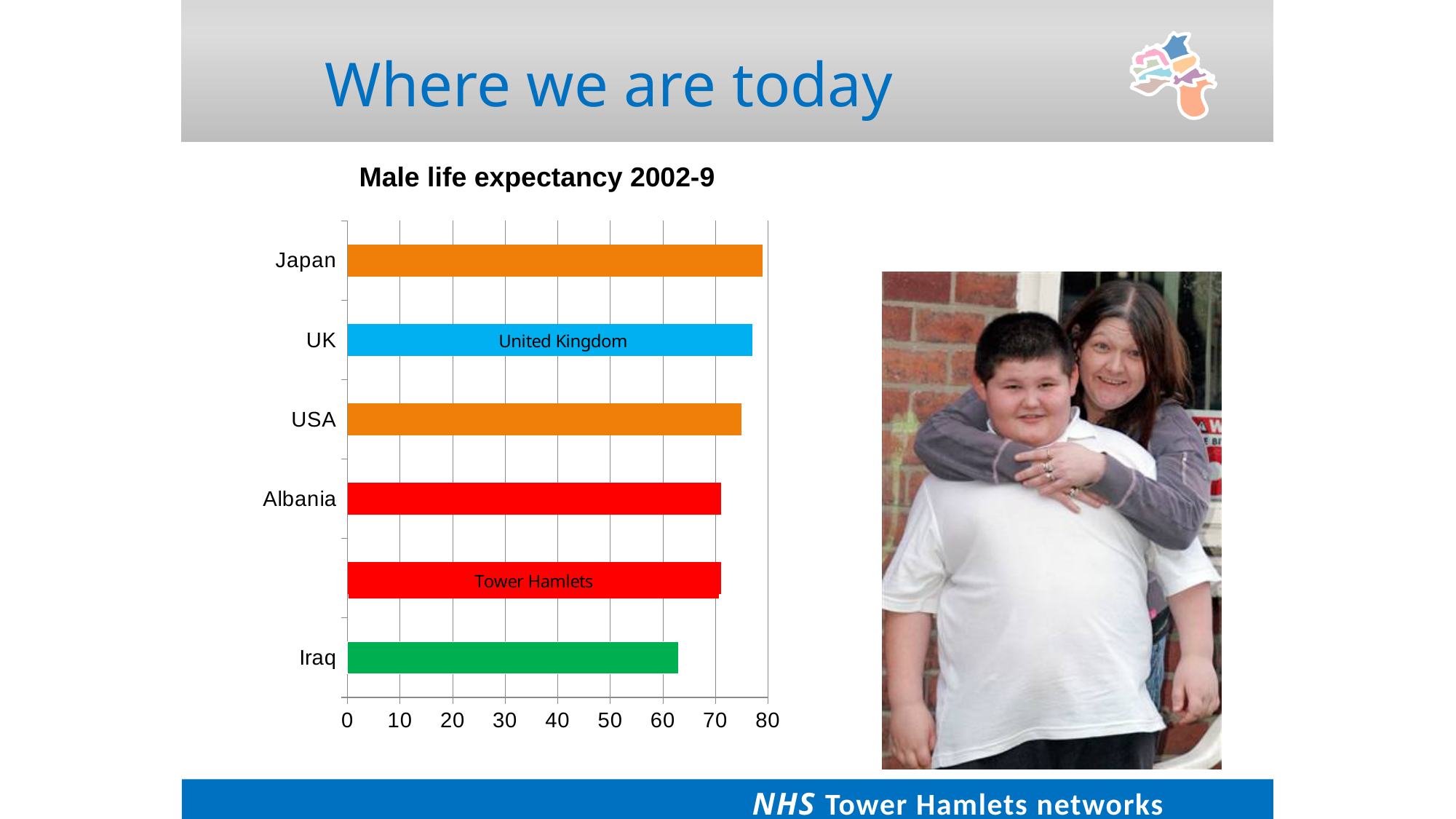
Is the value for Tower Hamlets greater or less than 60? greater Is the value for Japan greater or less than 70? greater Is the value for Iraq greater or less than 70? less Which is larger, the value for Japan or the value for Iraq? Japan What is the title of the chart? Male life expectancy 2002-9 Which category has the highest male life expectancy in the chart? Japan How many bars are plotted in the chart? 6 Which is larger, the value for USA or the value for Albania? USA What colour is the bar for Iraq? green Which category has the lowest male life expectancy in the chart? Iraq What kind of chart is shown on the slide? bar chart